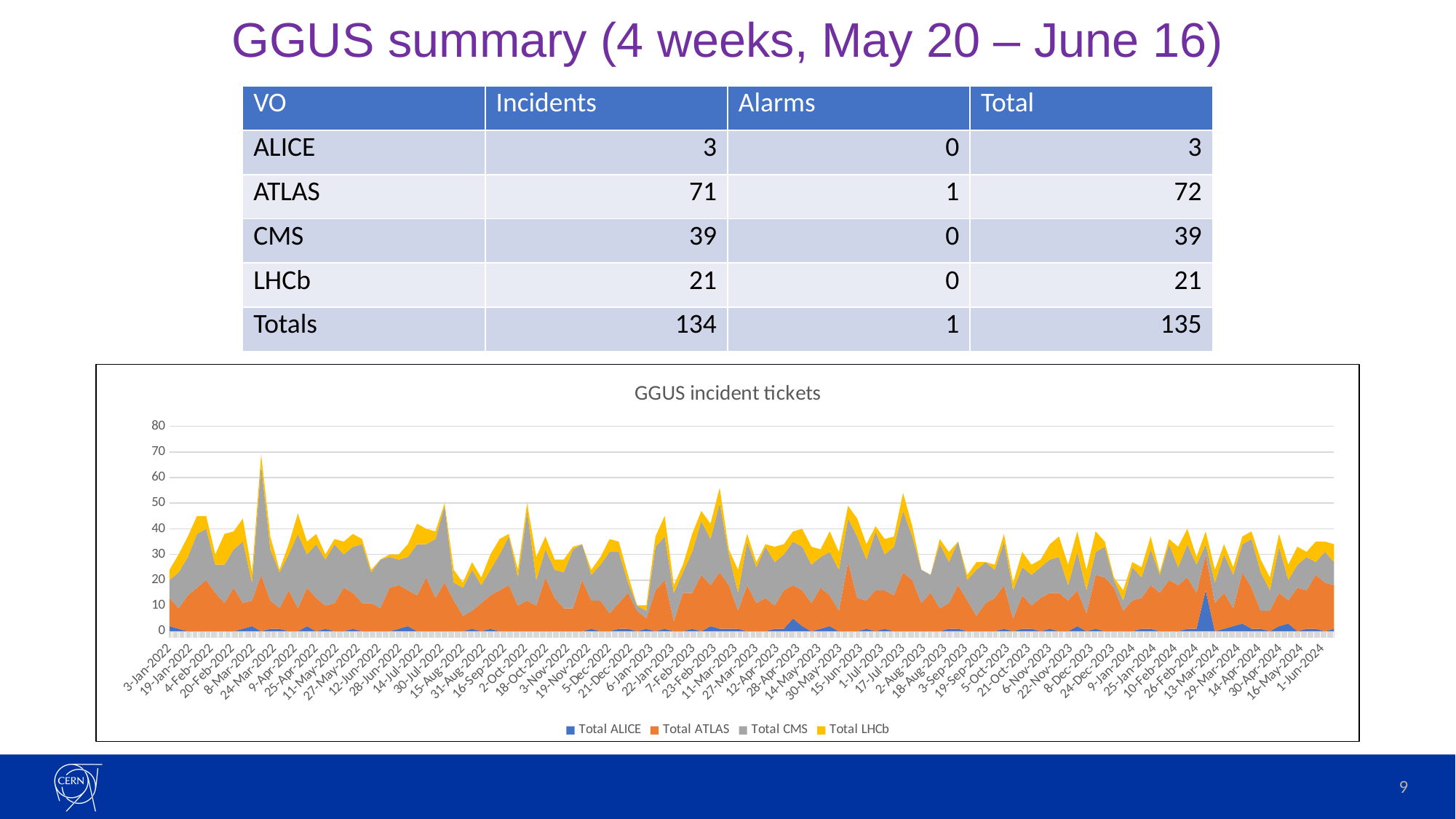
How many series does the legend of the "GGUS incident tickets" chart list? 4 In the "GGUS incident tickets" chart, is the highest stacked total (around 24-Mar-2022) greater or less than 60? greater What is the maximum value shown on the vertical axis of the "GGUS incident tickets" chart? 80 Which series is shown in yellow in the "GGUS incident tickets" chart? Total LHCb What is the title of the chart on the slide? GGUS incident tickets What kind of chart is the "GGUS incident tickets" chart? stacked area chart In the "GGUS incident tickets" chart, which series generally contributes the smallest area across the period? Total ALICE In the "GGUS incident tickets" chart, is the stacked total at 1-Jun-2024 greater or less than 50? less